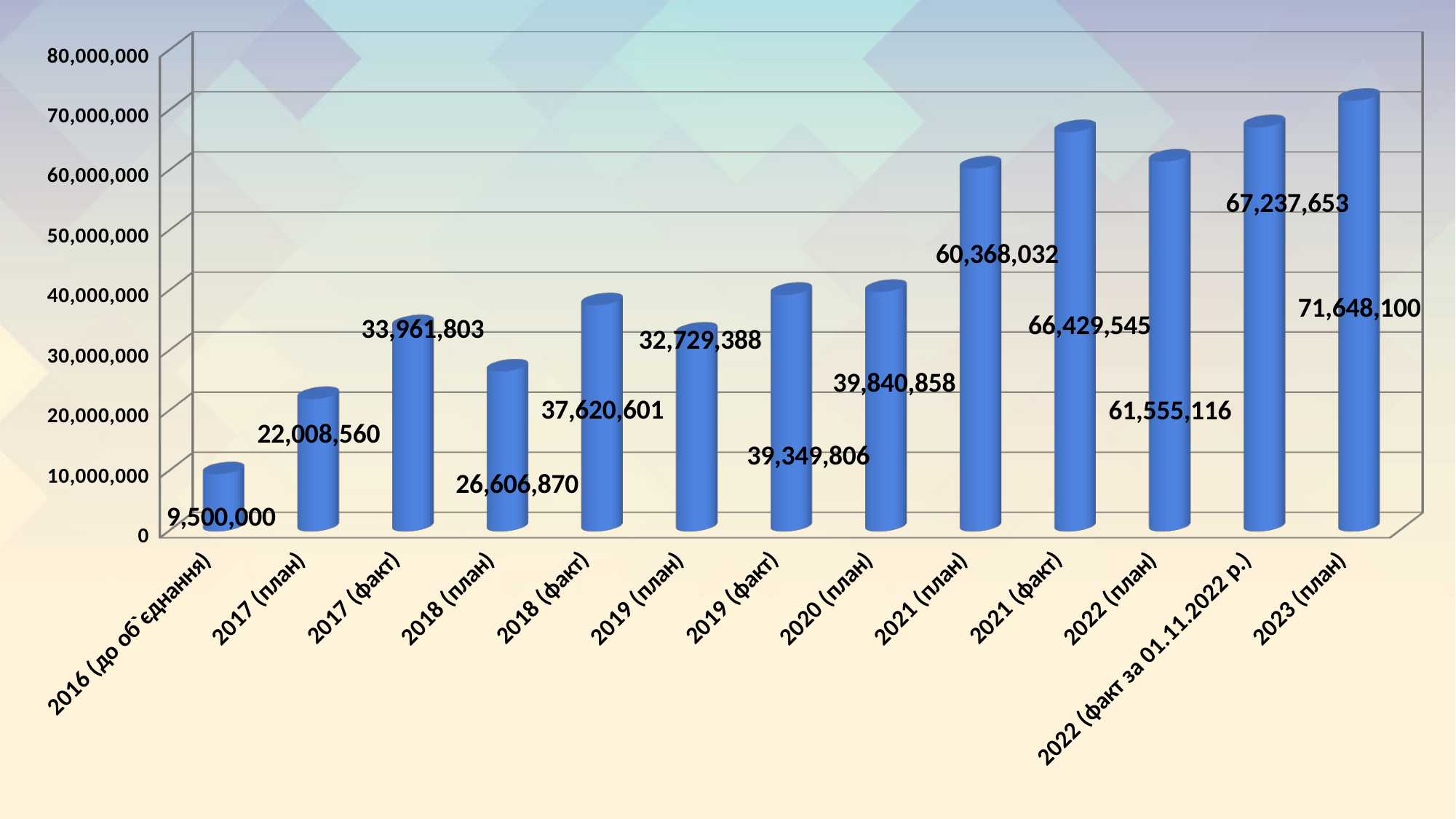
What is the difference between 2017 (факт) and 2017 (план)? 11,953,243 Is the value for 2020 (план) greater or less than 40,000,000? less Do the values generally rise or fall from 2016 to 2023 (план)? rise How many categories are shown on the x axis? 13 Which category has the highest value? 2023 (план) What kind of chart is this? bar chart Which is larger, 2018 (план) or 2019 (план)? 2019 (план) Which category has the lowest value? 2016 (до об`єднання) What is the value for 2019 (факт)? 39,349,806 What is the value for 2022 (факт за 01.11.2022 р.)? 67,237,653 What is the value for 2016 (до об`єднання)? 9,500,000 What is the difference between 2021 (факт) and 2021 (план)? 6,061,513